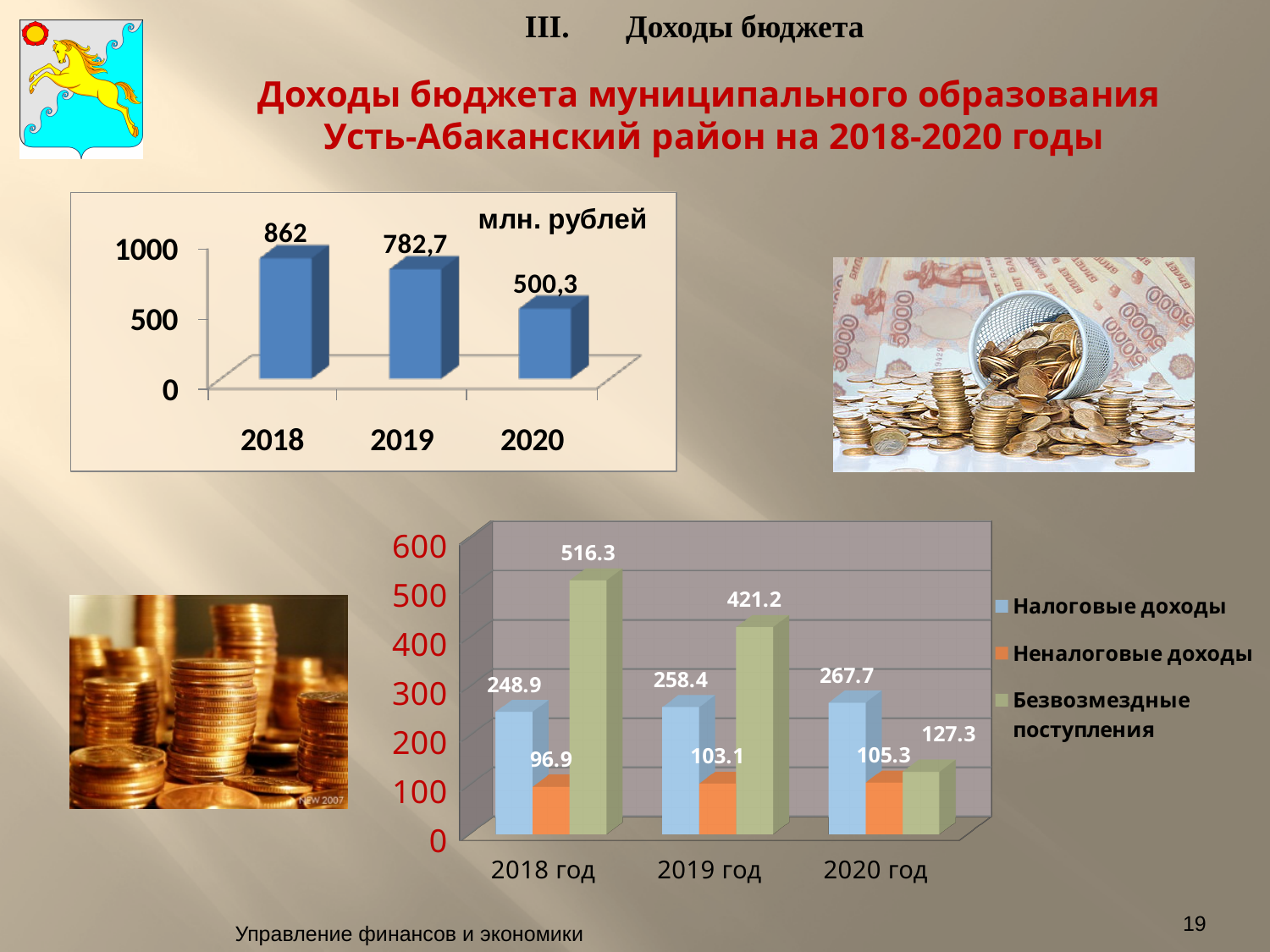
In the bottom chart, what is the value of Безвозмездные поступления for 2020 год? 127.3 In the bottom chart, which is larger for 2020 год: Налоговые доходы or Безвозмездные поступления? Налоговые доходы In the top-left chart, what is the value for 2020? 500,3 In the top-left chart, what unit is shown in the chart? млн. рублей In the top-left chart, which year has the lowest value? 2020 In the bottom chart, what is the value of Налоговые доходы for 2019 год? 258.4 In the top-left chart, what is the difference between the 2018 and 2019 values? 79,3 In the top-left chart, what is the value for 2018? 862 In the bottom chart, how many series does the legend list? 3 In the bottom chart, which year has the highest value of Безвозмездные поступления? 2018 год In the top-left chart, do the values rise or fall from 2018 to 2020? fall What type of chart is the bottom chart? bar chart